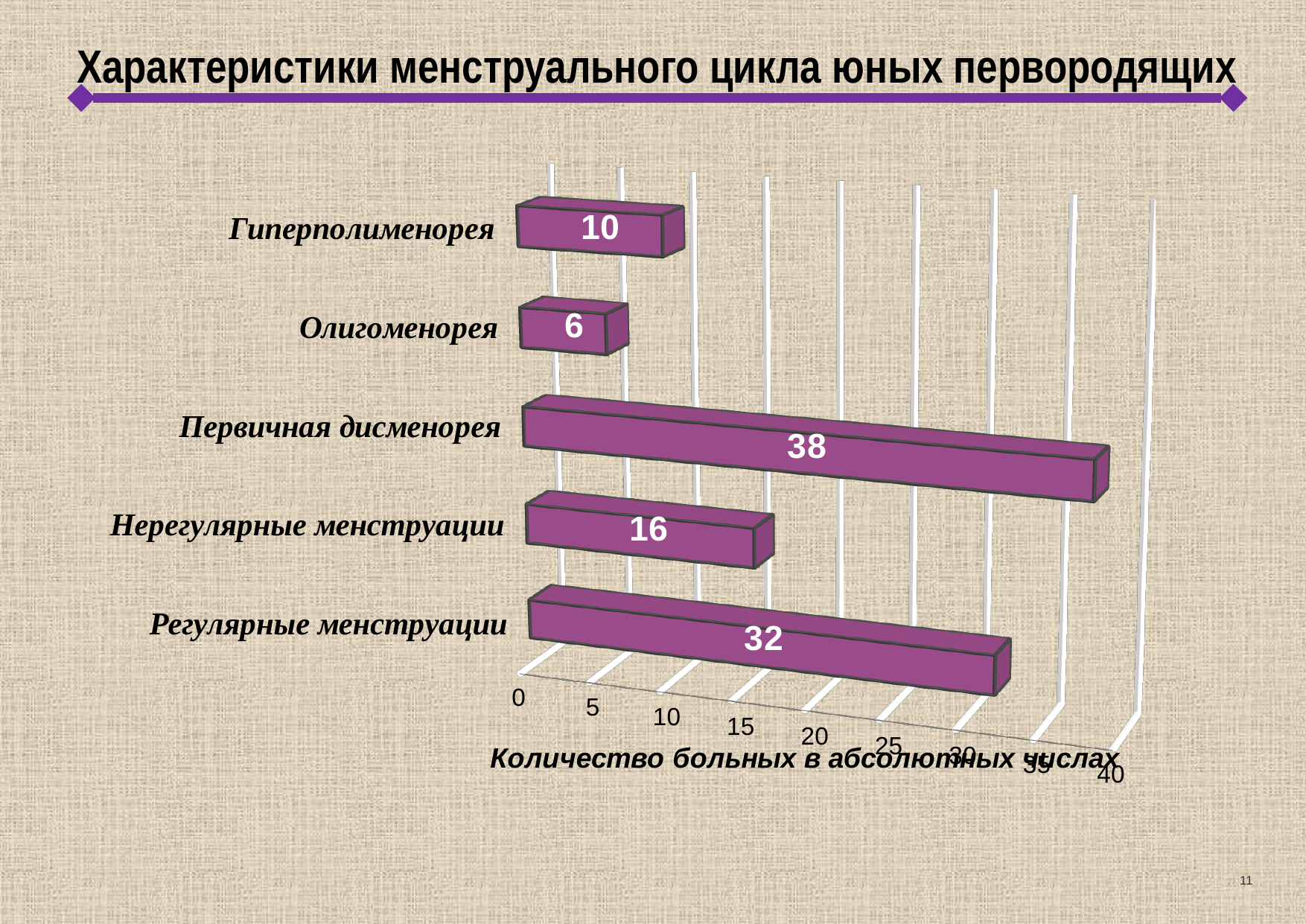
What is the value for Регулярные менструации? 32 What is the value for Олигоменорея? 6 Which category has the lowest value? Олигоменорея What is the difference between the values for Регулярные менструации and Нерегулярные менструации? 16 Which is larger, the value for Гиперполименорея or the value for Олигоменорея? Гиперполименорея What is the value for Нерегулярные менструации? 16 How many categories are shown in the chart? 5 What is the difference between the values for Первичная дисменорея and Гиперполименорея? 28 What is the value for Первичная дисменорея? 38 What kind of chart is shown on the slide? Bar chart What is the label of the horizontal axis? Количество больных в абсолютных числах Which category has the highest value? Первичная дисменорея